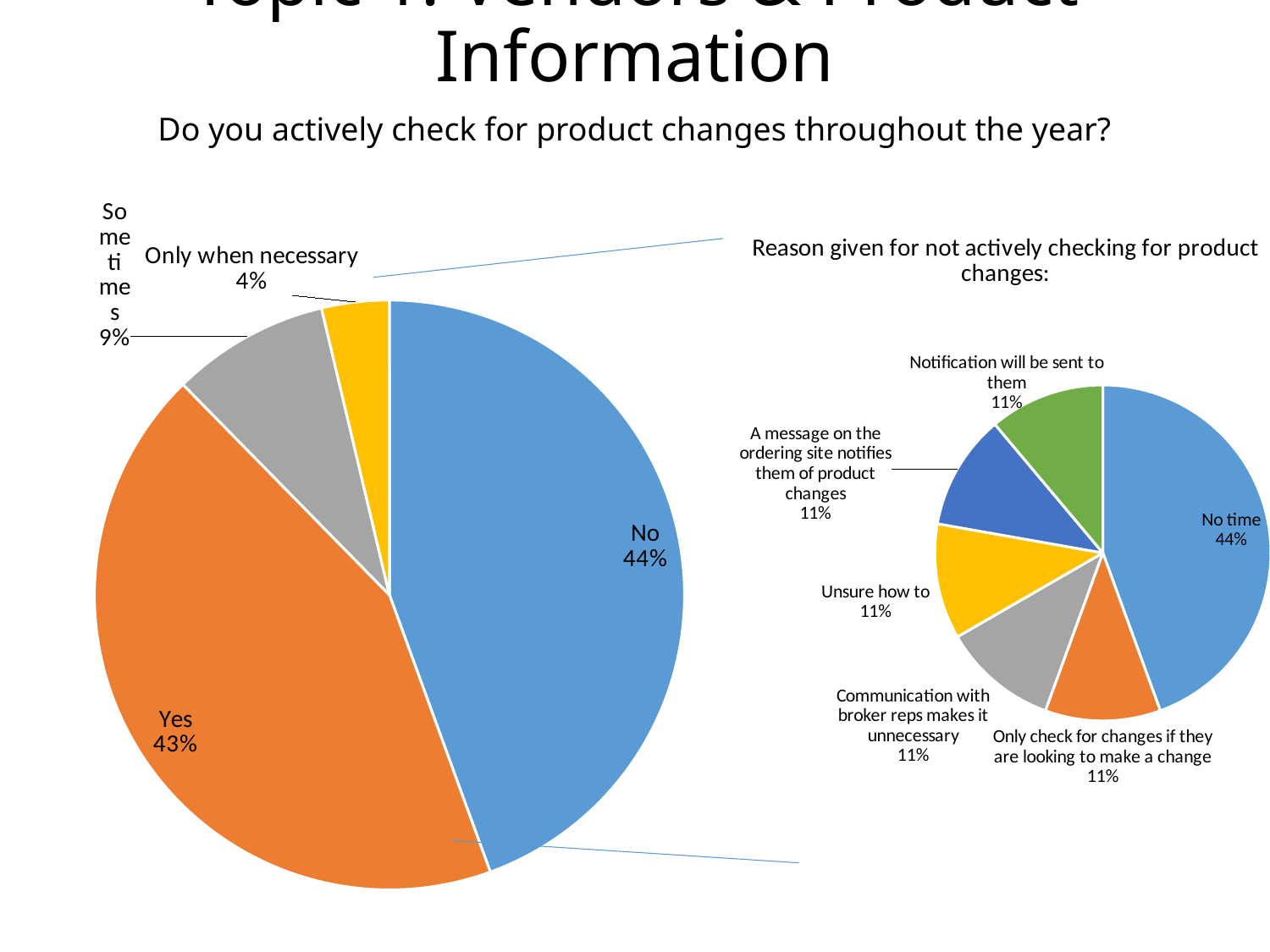
In the pie chart titled "Do you actively check for product changes throughout the year?", how many slices does the pie have? 4 In the pie chart titled "Do you actively check for product changes throughout the year?", what share is labelled "Sometimes"? 9% What type of chart is the chart titled "Reason given for not actively checking for product changes:"? Pie chart In the pie chart titled "Do you actively check for product changes throughout the year?", what is the difference in percentage points between the "Sometimes" and "Only when necessary" shares? 5 In the chart titled "Reason given for not actively checking for product changes:", what share is labelled "No time"? 44% In the pie chart titled "Do you actively check for product changes throughout the year?", what share of respondents answered "Yes"? 43% In the pie chart titled "Do you actively check for product changes throughout the year?", what share is labelled "Only when necessary"? 4% In the chart titled "Reason given for not actively checking for product changes:", how many slices does the pie have? 6 In the chart titled "Reason given for not actively checking for product changes:", which reason has the largest share? No time In the pie chart titled "Do you actively check for product changes throughout the year?", which response has the smallest share? Only when necessary In the chart titled "Reason given for not actively checking for product changes:", what share is labelled "Unsure how to"? 11% In the pie chart titled "Do you actively check for product changes throughout the year?", what share of respondents answered "No"? 44%